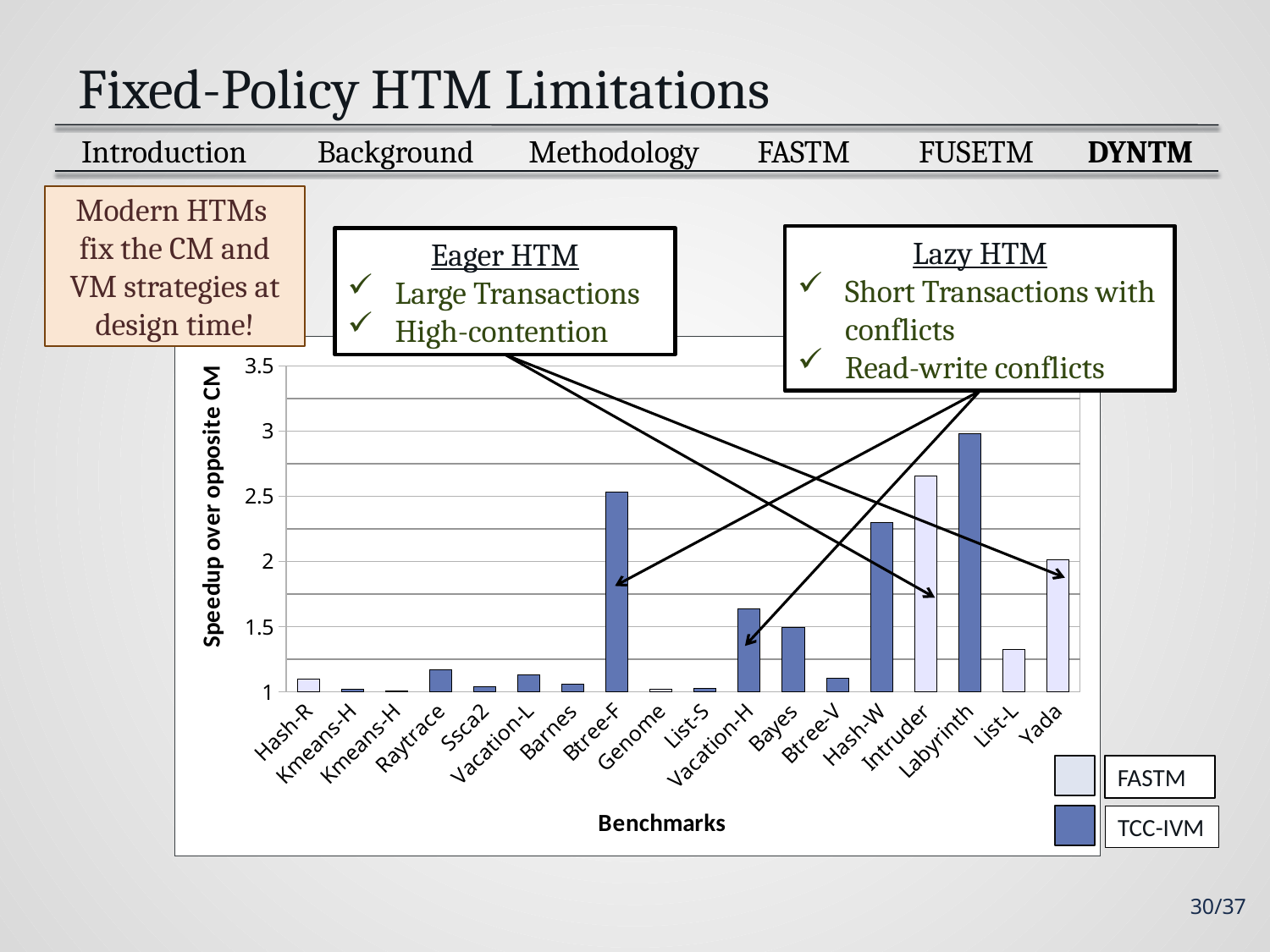
Which has a higher speedup, Labyrinth or Intruder? Labyrinth Is the value for Vacation-H greater or less than 2? less Is the value for Btree-F greater or less than 2? greater Is the value for Intruder greater or less than 2.5? greater Which has a higher speedup, Hash-W or Vacation-H? Hash-W What kind of chart is shown on the slide? bar chart Which legend entry is shown with the darker blue fill? TCC-IVM How many series does the chart legend list? 2 How many benchmarks are shown along the x axis of the chart? 18 What is the label of the y axis of the chart? Speedup over opposite CM Which benchmark has the highest speedup in the chart? Labyrinth